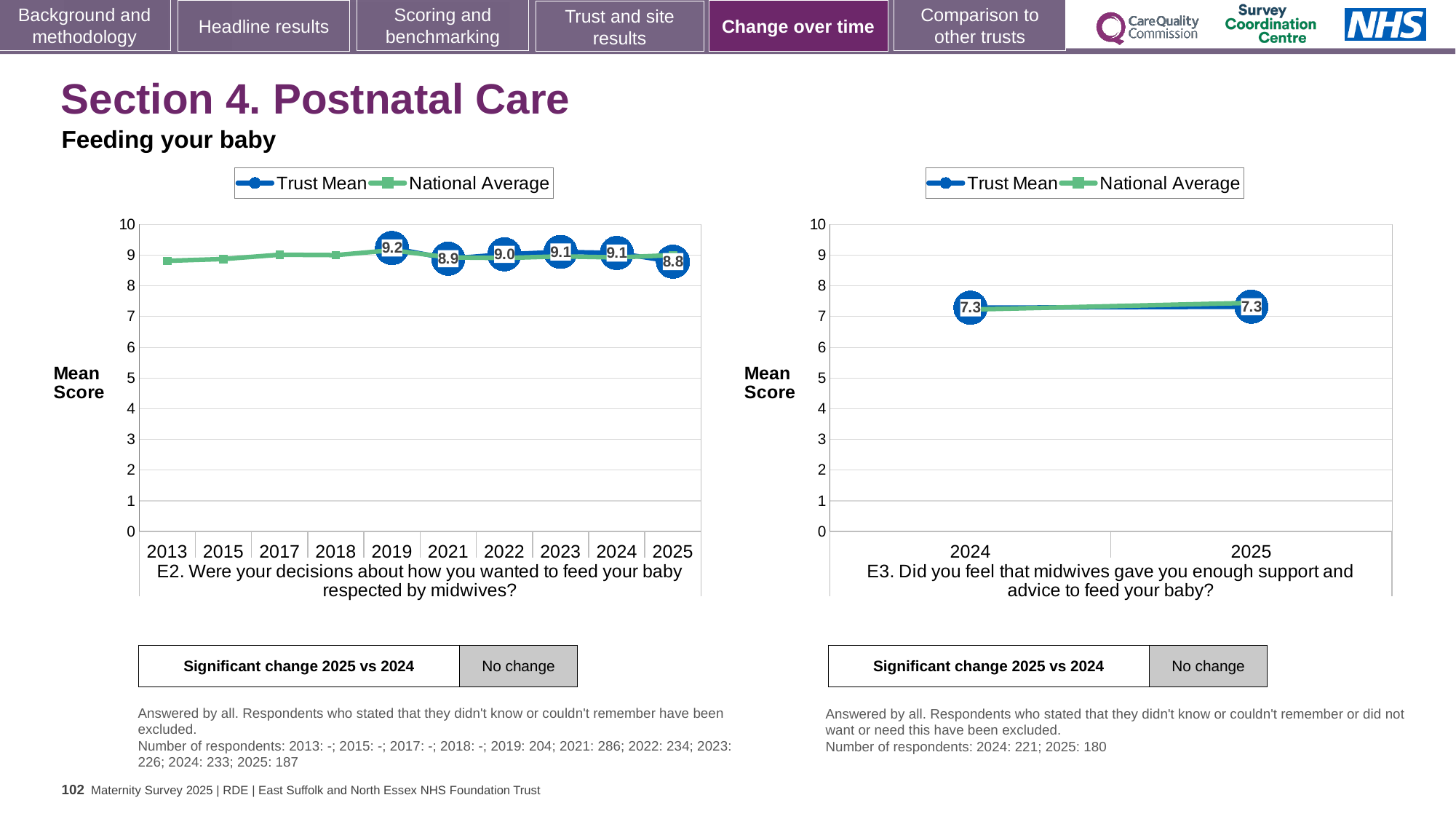
In the E2 chart (left), which year has the highest labelled Trust Mean? 2019 What type of chart is the E3 chart (right)? Line chart How many series does the legend of the E3 chart (right) list? 2 In the E2 chart (left), what is the difference between the Trust Mean for 2019 and the Trust Mean for 2025? 0.4 In the E2 chart (left), is the Trust Mean for 2021 higher or lower than the Trust Mean for 2023? lower In the E3 chart (right), is the Trust Mean for 2025 greater or less than 8? less In the E3 chart (right), what is the Trust Mean for 2024? 7.3 In the E2 chart (left), is the National Average for 2013 greater or less than 5? greater In the E2 chart (left), which year has the lowest labelled Trust Mean? 2025 How many years are shown on the x axis of the E2 chart (left)? 10 In the E2 chart (left), what is the Trust Mean for 2025? 8.8 In the E2 chart (left), what is the Trust Mean for 2019? 9.2